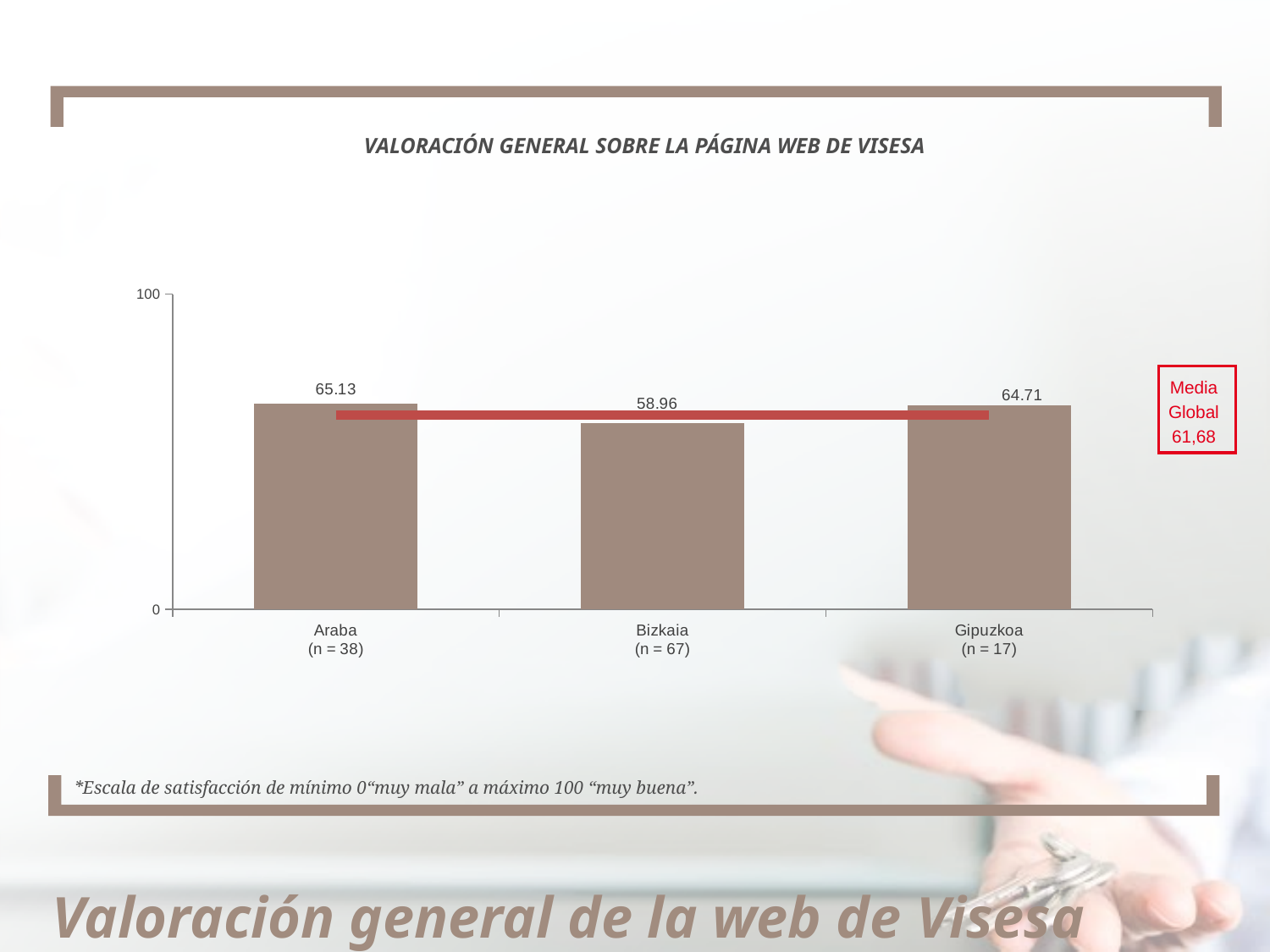
What is the value for Gipuzkoa? 64.71 How many categories are shown on the x axis? 3 Which category has the lowest value? Bizkaia Which is larger, the value for Gipuzkoa or the value for Bizkaia? Gipuzkoa Which category has the highest value? Araba What is the value for Araba? 65.13 What is the value for Bizkaia? 58.96 What is the difference between the values for Gipuzkoa and Bizkaia? 5.75 What is the Media Global value shown in the red box? 61,68 What is the sample size (n) for Bizkaia? 67 What is the difference between the values for Araba and Bizkaia? 6.17 What kind of chart is this? bar chart